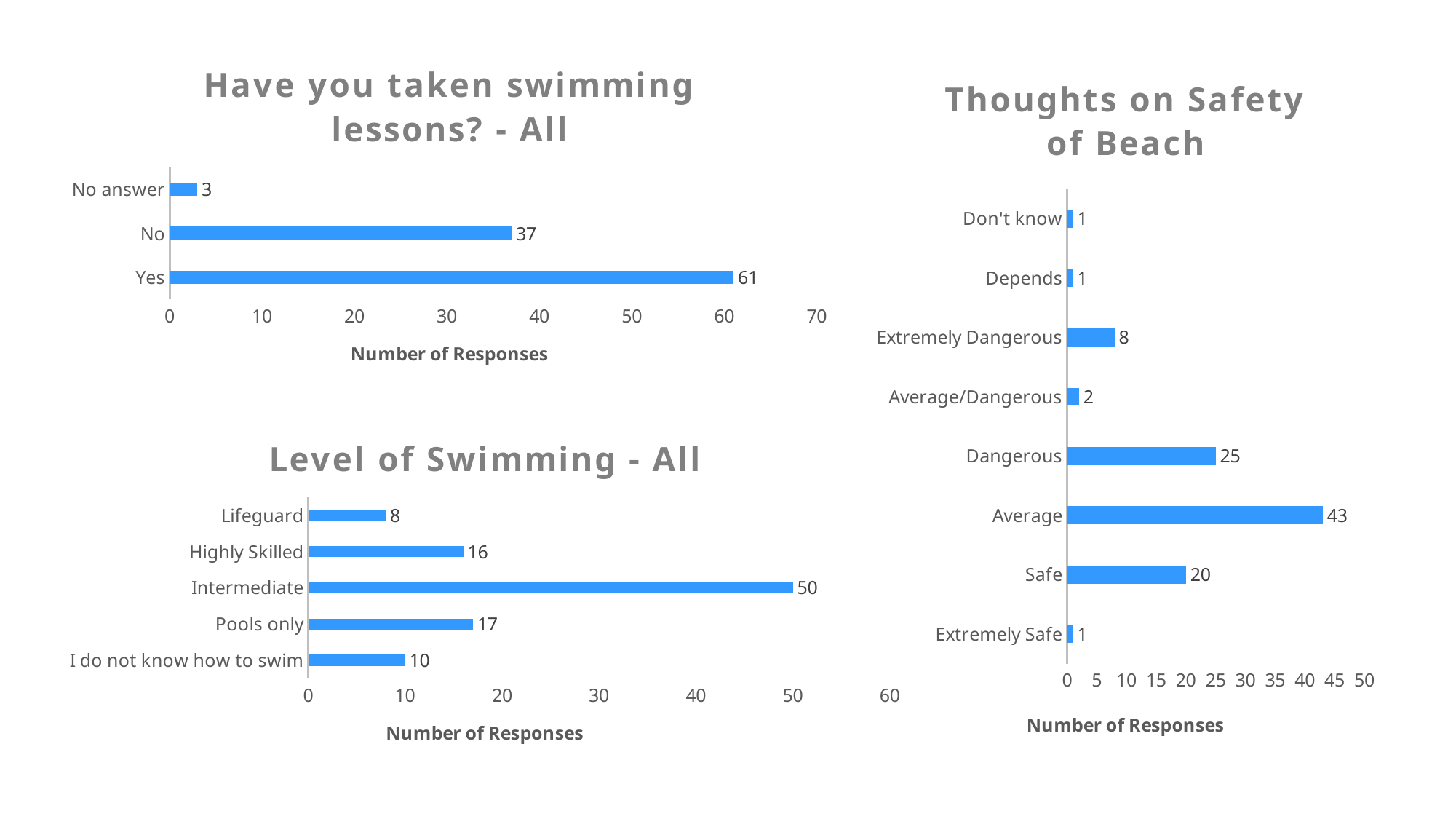
In the 'Level of Swimming - All' chart, which has more responses, 'Highly Skilled' or 'I do not know how to swim'? Highly Skilled In the 'Thoughts on Safety of Beach' chart, how many responses are there for 'Dangerous'? 25 In the 'Level of Swimming - All' chart, how many responses are there for 'Pools only'? 17 In the 'Thoughts on Safety of Beach' chart, how many categories are shown? 8 In the 'Thoughts on Safety of Beach' chart, which category has the highest number of responses? Average In the 'Have you taken swimming lessons? - All' chart, which category has the lowest number of responses? No answer What type of chart is 'Thoughts on Safety of Beach'? Bar chart In the 'Thoughts on Safety of Beach' chart, what is the difference between 'Average' and 'Safe' responses? 23 In the 'Level of Swimming - All' chart, which category has the highest number of responses? Intermediate In the 'Have you taken swimming lessons? - All' chart, what is the difference between the 'Yes' and 'No' responses? 24 In the 'Have you taken swimming lessons? - All' chart, how many responses are there for 'Yes'? 61 In the 'Level of Swimming - All' chart, how many categories are shown? 5